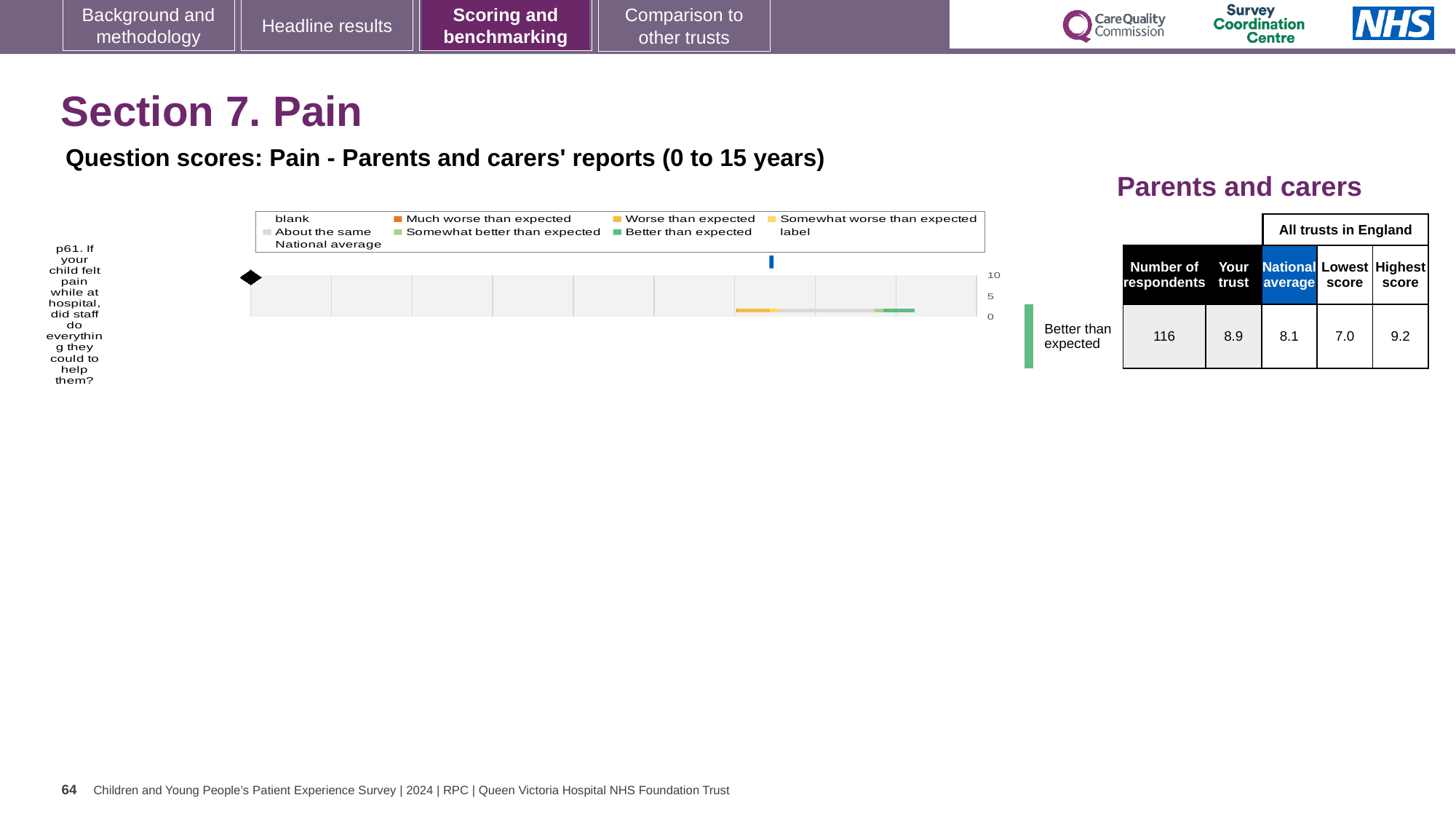
How many entries does the chart legend list? 9 What is the highest score among all trusts in England for question p61? 9.2 What is the lowest score among all trusts in England for question p61? 7.0 What kind of chart is shown on the slide? bar chart What is the 'Your trust' score for question p61? 8.9 Which survey question is plotted in the chart? p61. If your child felt pain while at hospital, did staff do everything they could to help them? How many survey questions are plotted in the chart? 1 Which is larger for question p61, the 'Your trust' score or the national average? Your trust What is the difference between the 'Your trust' score and the national average for question p61? 0.8 Which benchmarking category is shown for question p61? Better than expected Is the 'Your trust' score for question p61 greater or less than 5? greater What is the national average score for question p61? 8.1